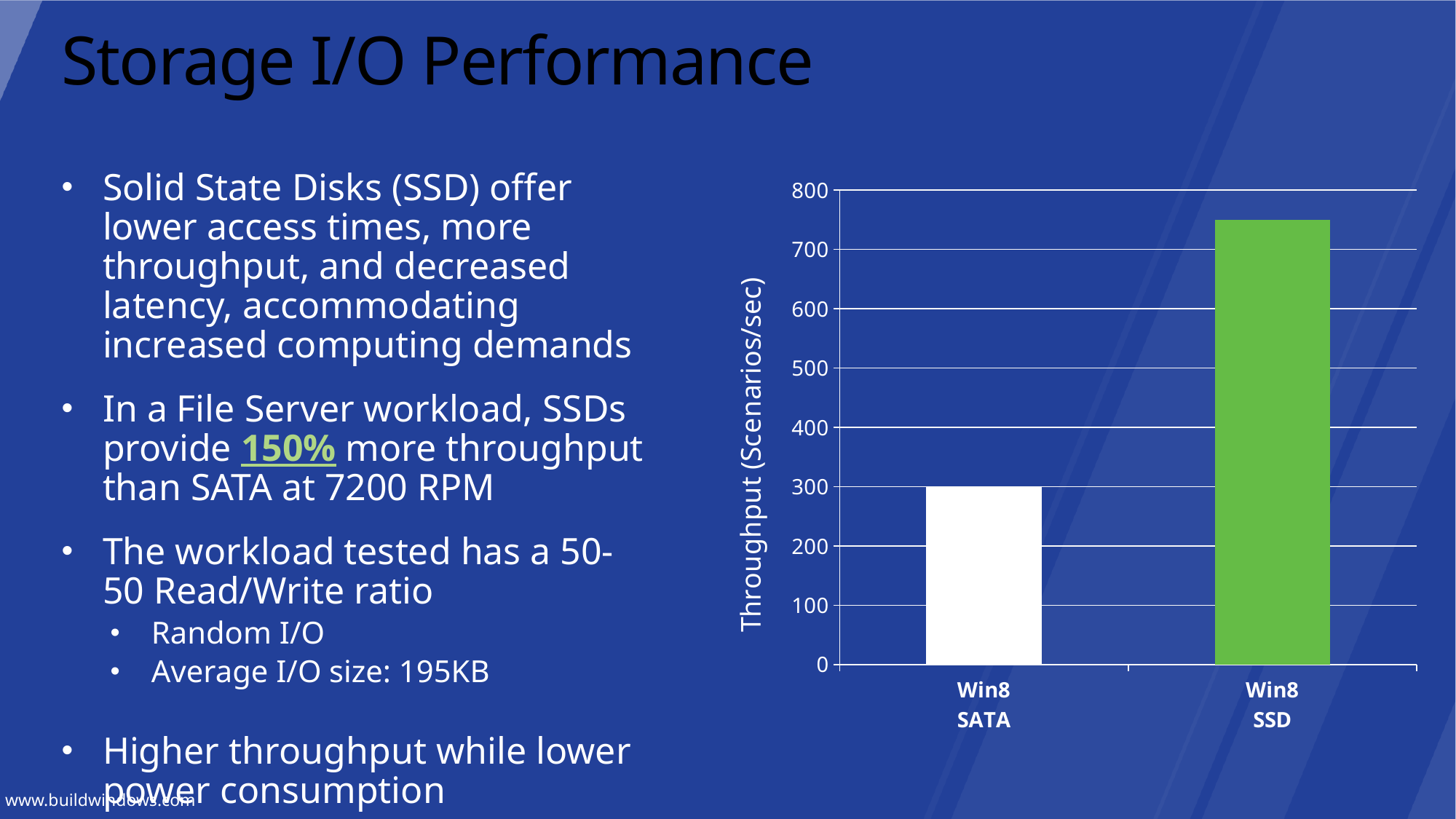
Is the value for Win8 SATA greater or less than 400? less How many bars are plotted in the chart? 2 Which is larger, the throughput for Win8 SATA or Win8 SSD? Win8 SSD What type of chart is shown on the slide? bar chart Is the value for Win8 SSD greater or less than 800? less Which category has the lowest throughput? Win8 SATA What is the label of the vertical axis? Throughput (Scenarios/sec) What colour is the bar for Win8 SSD? green Which category has the highest throughput? Win8 SSD Is the value for Win8 SSD greater or less than 700? greater What is the maximum value shown on the vertical axis? 800 What is the throughput value for Win8 SATA? 300